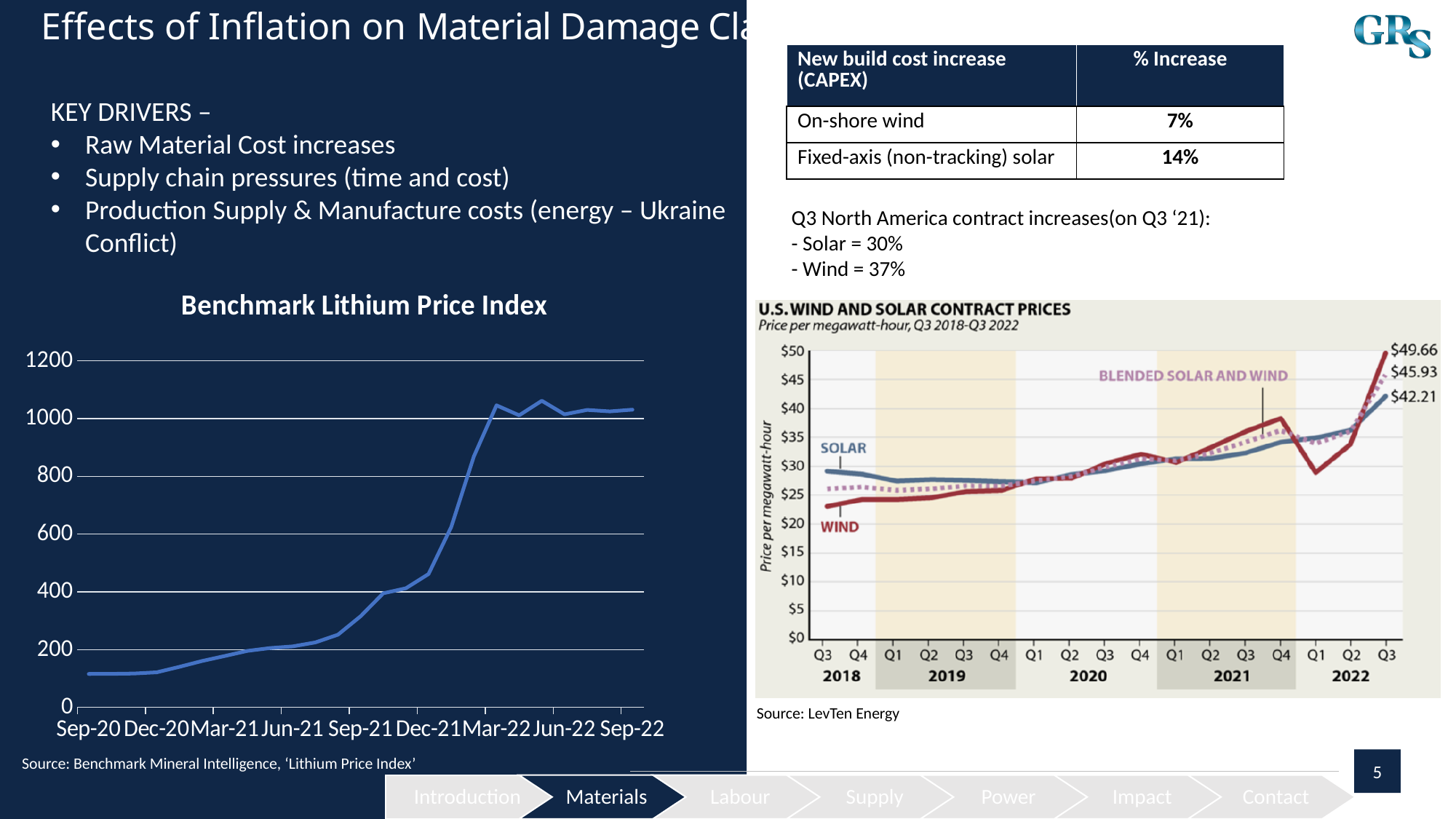
In the Benchmark Lithium Price Index chart, does the index rise or fall from Sep-20 to Sep-22? rise In the U.S. Wind and Solar Contract Prices chart, what is the wind price per megawatt-hour in Q3 2022? $49.66 In the Benchmark Lithium Price Index chart, is the value for Sep-20 greater or less than 200? less In the U.S. Wind and Solar Contract Prices chart, what is the solar price per megawatt-hour in Q3 2022? $42.21 In the Benchmark Lithium Price Index chart, is the value for Dec-21 greater or less than 400? greater In the U.S. Wind and Solar Contract Prices chart, what is the blended solar and wind price in Q3 2022? $45.93 In the U.S. Wind and Solar Contract Prices chart, how many series are plotted? 3 In the Benchmark Lithium Price Index chart, is the value for Sep-21 greater or less than 400? less What type of chart is the Benchmark Lithium Price Index chart? line chart In the Benchmark Lithium Price Index chart, what is the highest value shown on the vertical axis? 1200 In the U.S. Wind and Solar Contract Prices chart, what is the difference between the wind and solar prices in Q3 2022? $7.45